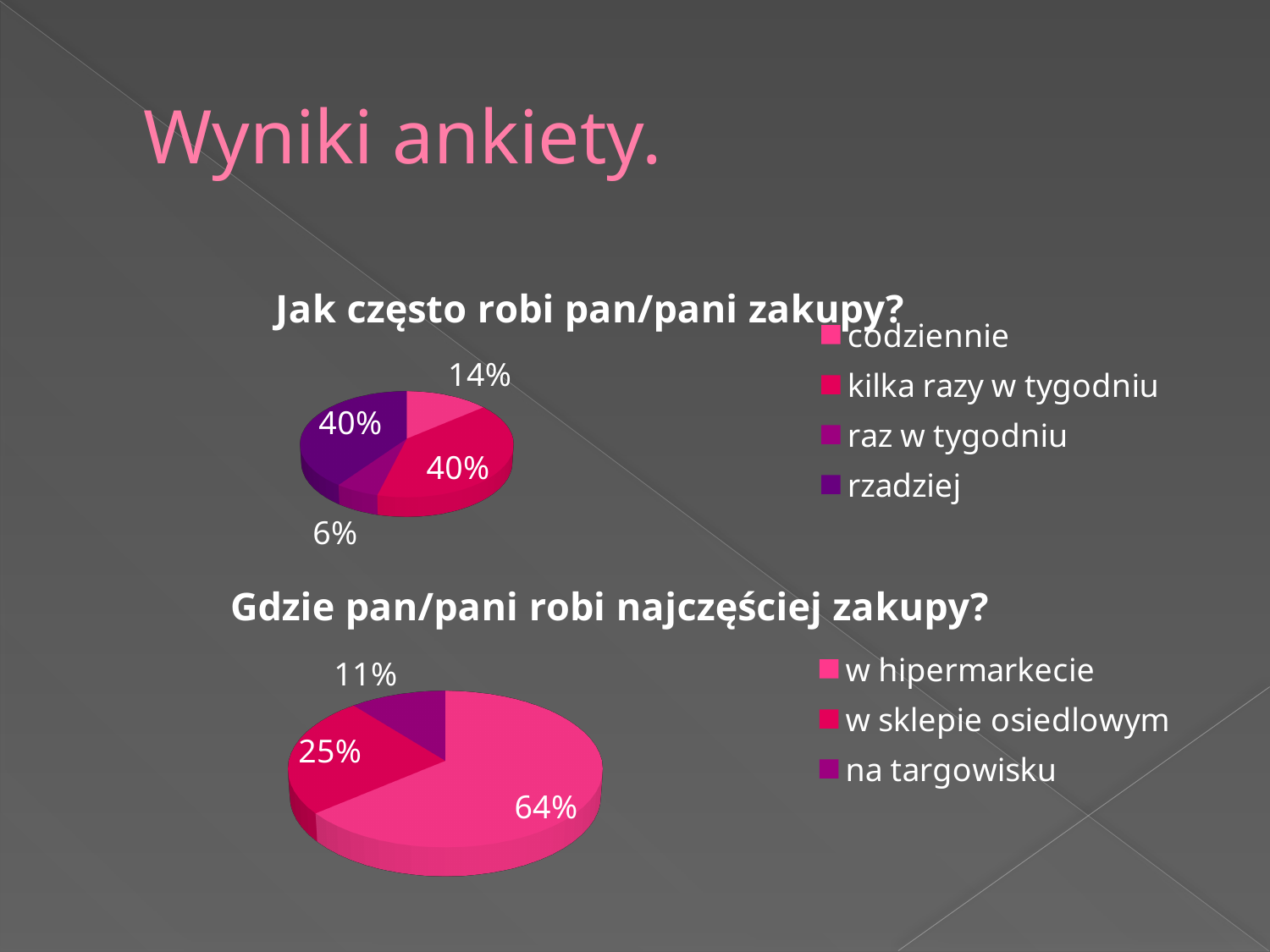
In the chart 'Jak często robi pan/pani zakupy?', what share is shown for 'codziennie'? 14% In the chart 'Jak często robi pan/pani zakupy?', what share is shown for 'raz w tygodniu'? 6% In the chart 'Gdzie pan/pani robi najczęściej zakupy?', what is the difference between the shares for 'w hipermarkecie' and 'w sklepie osiedlowym'? 39% In the chart 'Gdzie pan/pani robi najczęściej zakupy?', which is larger: 'w sklepie osiedlowym' or 'na targowisku'? w sklepie osiedlowym In the chart 'Jak często robi pan/pani zakupy?', how many categories does the legend list? 4 In the chart 'Gdzie pan/pani robi najczęściej zakupy?', which category has the largest slice? w hipermarkecie In the chart 'Jak często robi pan/pani zakupy?', what is the difference between the shares for 'kilka razy w tygodniu' and 'codziennie'? 26% What type of chart is used for 'Gdzie pan/pani robi najczęściej zakupy?'? pie chart In the chart 'Gdzie pan/pani robi najczęściej zakupy?', what share is shown for 'na targowisku'? 11% In the chart 'Gdzie pan/pani robi najczęściej zakupy?', what share is shown for 'w hipermarkecie'? 64% In the chart 'Jak często robi pan/pani zakupy?', which category has the smallest slice? raz w tygodniu How many charts are shown on the slide? 2